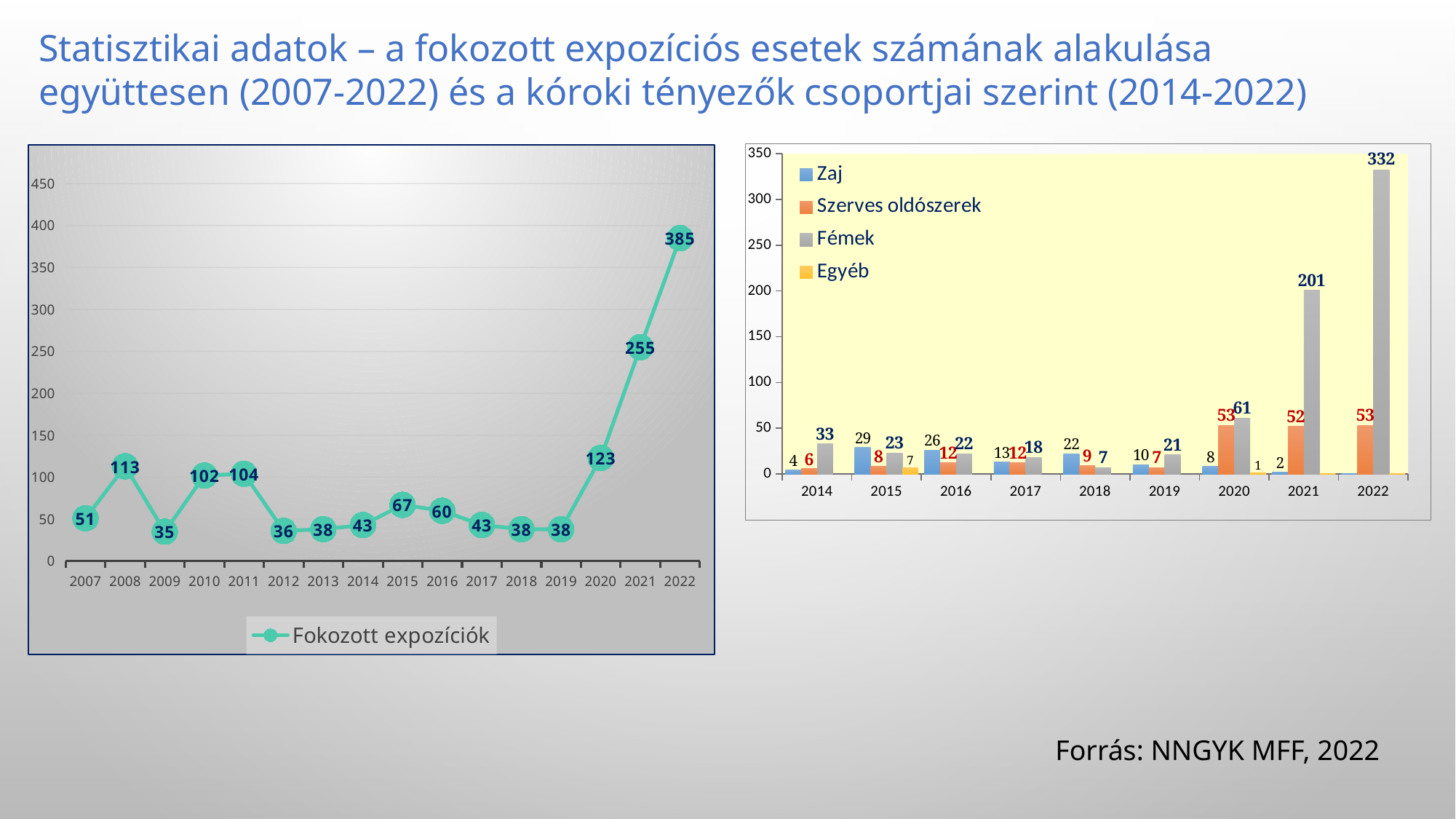
In the right bar chart, what is the difference between Fémek in 2022 and Fémek in 2021? 131 In the left line chart, what is the value for 2009? 35 In the left line chart, which year has the lowest value? 2009 In the left line chart, how many years are plotted on the x axis? 16 What kind of chart is the chart on the left? line chart In the right bar chart, how many series does the legend list? 4 In the right bar chart, what is the value for Fémek in 2021? 201 In the right bar chart, what is the value for Szerves oldószerek in 2020? 53 In the right bar chart, which is larger in 2015: Zaj or Fémek? Zaj In the left line chart, do the values rise or fall from 2019 to 2022? rise In the left line chart, what is the value for Fokozott expozíciók in 2022? 385 In the left line chart, what is the difference between the values for 2022 and 2021? 130